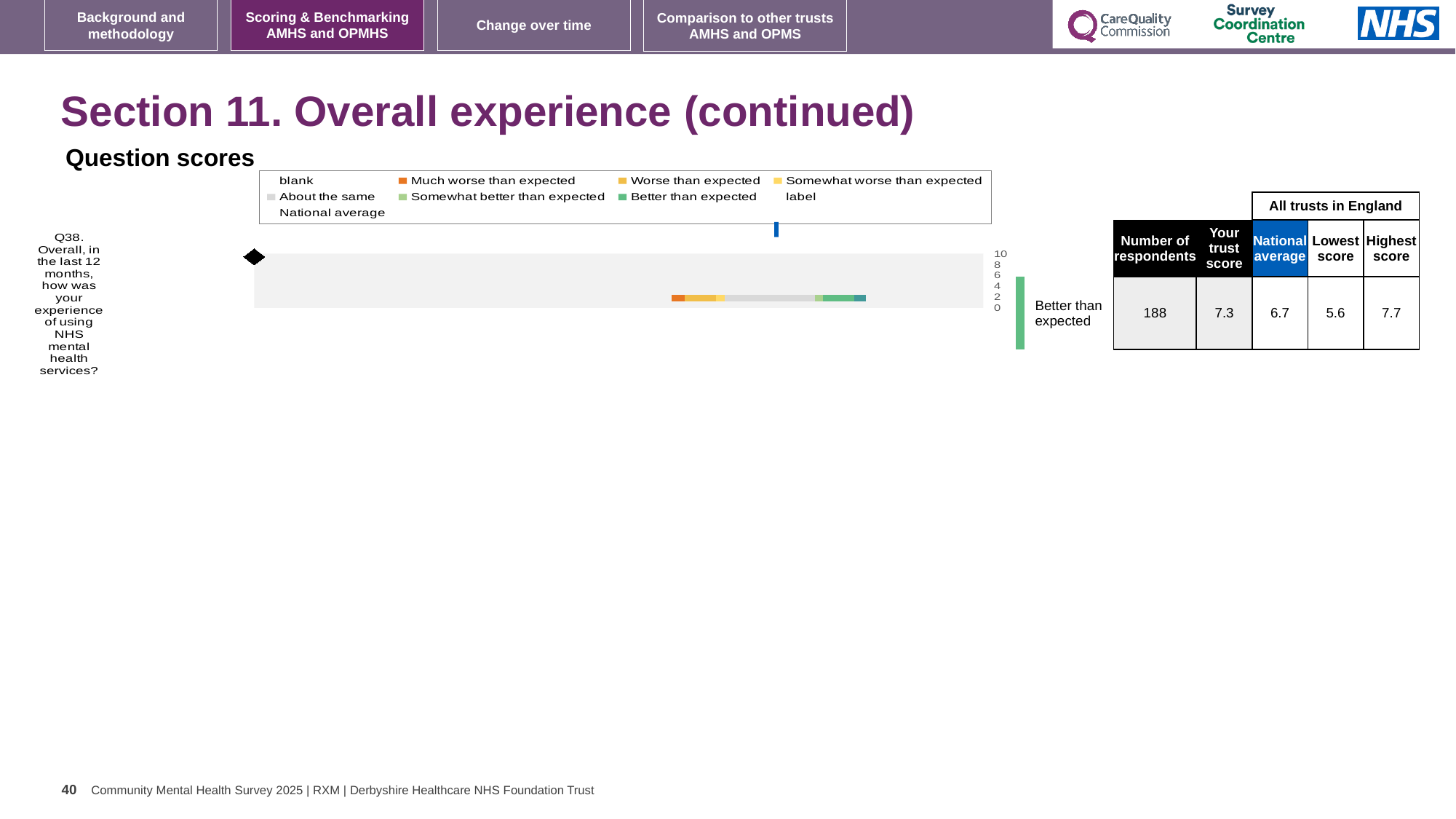
Which is larger for Q38, the trust's score or the national average? the trust's score Which question is plotted in the Question scores chart? Q38. Overall, in the last 12 months, how was your experience of using NHS mental health services? By how much does the trust's score for Q38 exceed the national average? 0.6 How many survey questions are plotted in the Question scores chart? 1 What is the difference between the highest and lowest scores for Q38 across all trusts in England? 2.1 How many respondents answered Q38? 188 What is the trust's score for Q38? 7.3 What benchmark category is shown next to the Q38 bar? Better than expected What is the highest score among all trusts in England for Q38? 7.7 What is the national average score for Q38? 6.7 What is the lowest score among all trusts in England for Q38? 5.6 What kind of chart is used to show the Q38 question score? bar chart